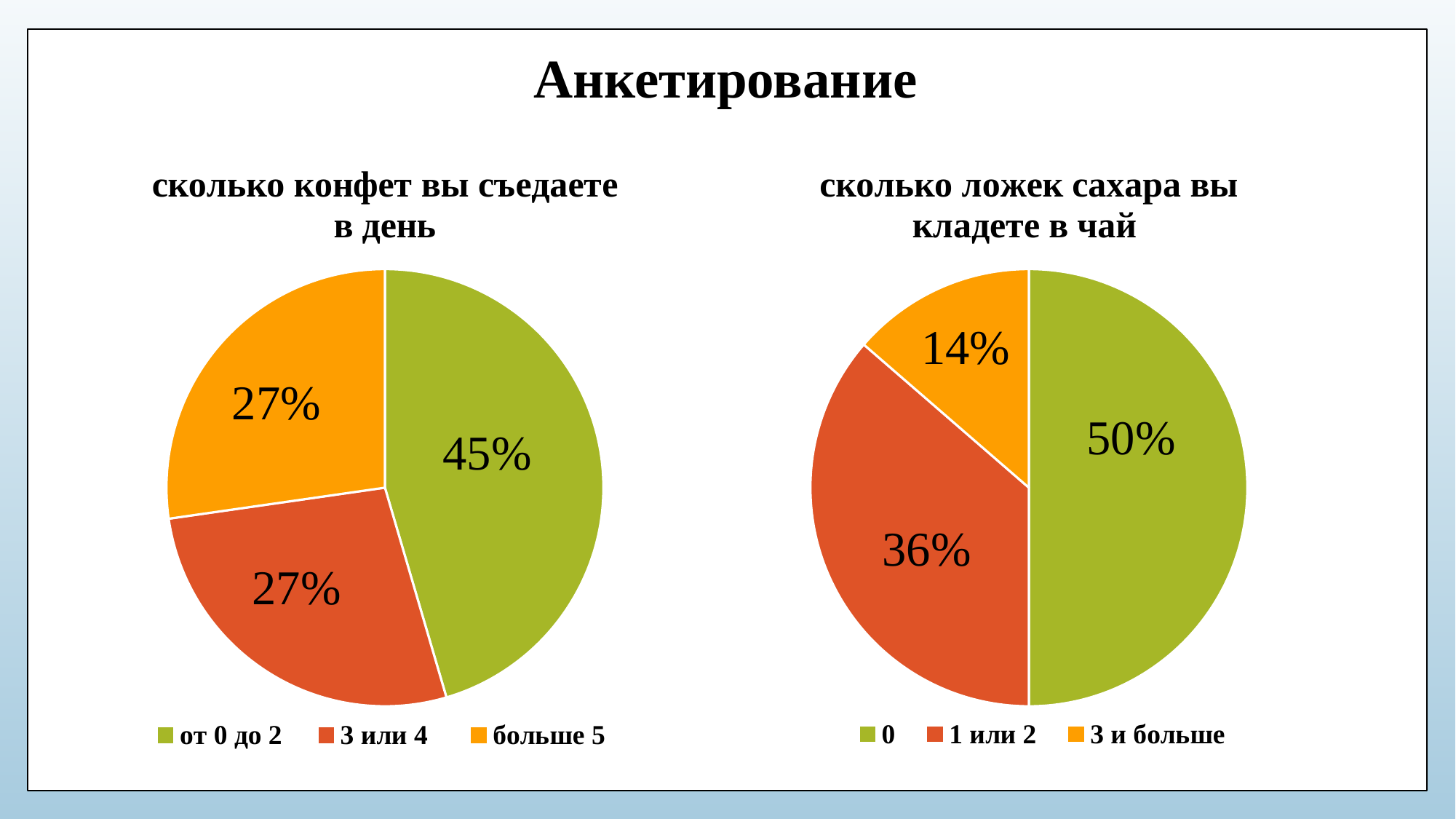
In the left chart 'сколько конфет вы съедаете в день', what share is labelled for 'от 0 до 2'? 45% In the right chart 'сколько ложек сахара вы кладете в чай', what is the difference between the '1 или 2' slice and the '3 и больше' slice? 22% In the right chart 'сколько ложек сахара вы кладете в чай', which is larger: the '0' slice or the '1 или 2' slice? 0 In the right chart 'сколько ложек сахара вы кладете в чай', how many entries does the legend list? 3 In the left chart 'сколько конфет вы съедаете в день', how many slices does the pie have? 3 In the right chart 'сколько ложек сахара вы кладете в чай', what share is labelled for '3 и больше'? 14% What type of chart is used on the left side of the slide? Pie chart In the right chart 'сколько ложек сахара вы кладете в чай', which category has the smallest slice? 3 и больше In the left chart 'сколько конфет вы съедаете в день', what is the difference between the 'от 0 до 2' slice and the '3 или 4' slice? 18% In the left chart 'сколько конфет вы съедаете в день', what share is labelled for 'больше 5'? 27% In the left chart 'сколько конфет вы съедаете в день', which category has the largest slice? от 0 до 2 In the right chart 'сколько ложек сахара вы кладете в чай', what share is labelled for '1 или 2'? 36%